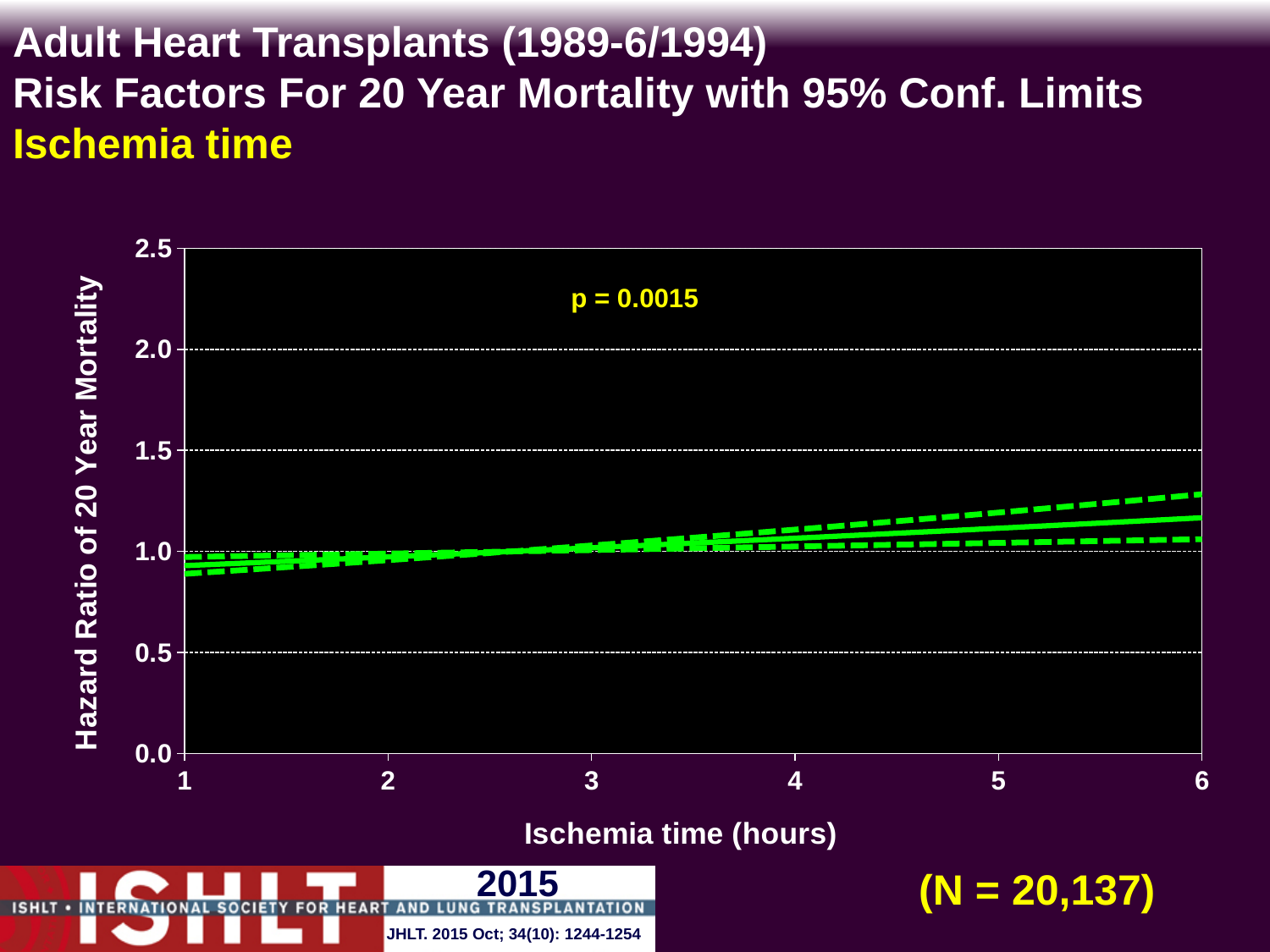
Is the hazard ratio at an ischemia time of 6 hours greater or less than 1.5? less Does the hazard ratio of 20 year mortality rise or fall as ischemia time increases from 1 to 6 hours? rise What p-value is printed on the chart? p = 0.0015 What kind of chart is shown on the slide? line chart Is the hazard ratio at an ischemia time of 1 hour greater or less than 1.0? less Is the hazard ratio at an ischemia time of 6 hours greater or less than 1.0? greater What sample size (N) is shown on the slide? N = 20,137 Is the hazard ratio higher at an ischemia time of 6 hours or at 1 hour? 6 hours